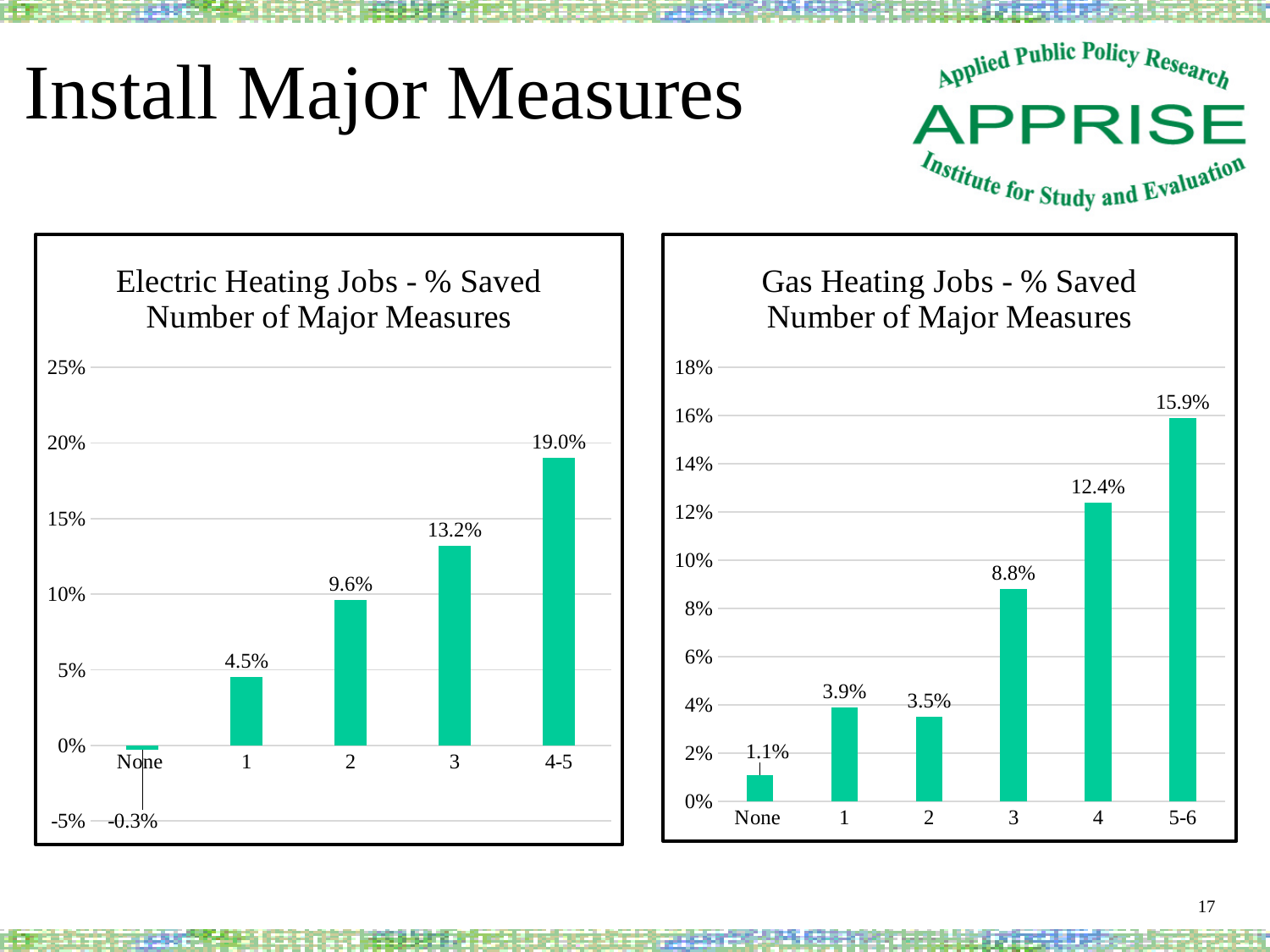
In the Electric Heating Jobs chart, what is the % saved for 2 major measures? 9.6% How many categories are shown on the x axis of the Gas Heating Jobs chart? 6 In the Gas Heating Jobs chart, which category has the highest % saved? 5-6 In the Gas Heating Jobs chart, which has a higher % saved: 1 major measure or 2 major measures? 1 In the Electric Heating Jobs chart, which category has the lowest % saved? None What kind of chart is the Electric Heating Jobs chart? Bar chart In the Electric Heating Jobs chart, do the values rise or fall as the number of major measures increases? Rise In the Electric Heating Jobs chart, what is the difference in % saved between 4-5 and 3 major measures? 5.8% How many categories are shown on the x axis of the Electric Heating Jobs chart? 5 In the Gas Heating Jobs chart, what is the % saved for 3 major measures? 8.8% In the Electric Heating Jobs chart, what is the % saved for None? -0.3% In the Gas Heating Jobs chart, what is the difference in % saved between 4 and 3 major measures? 3.6%